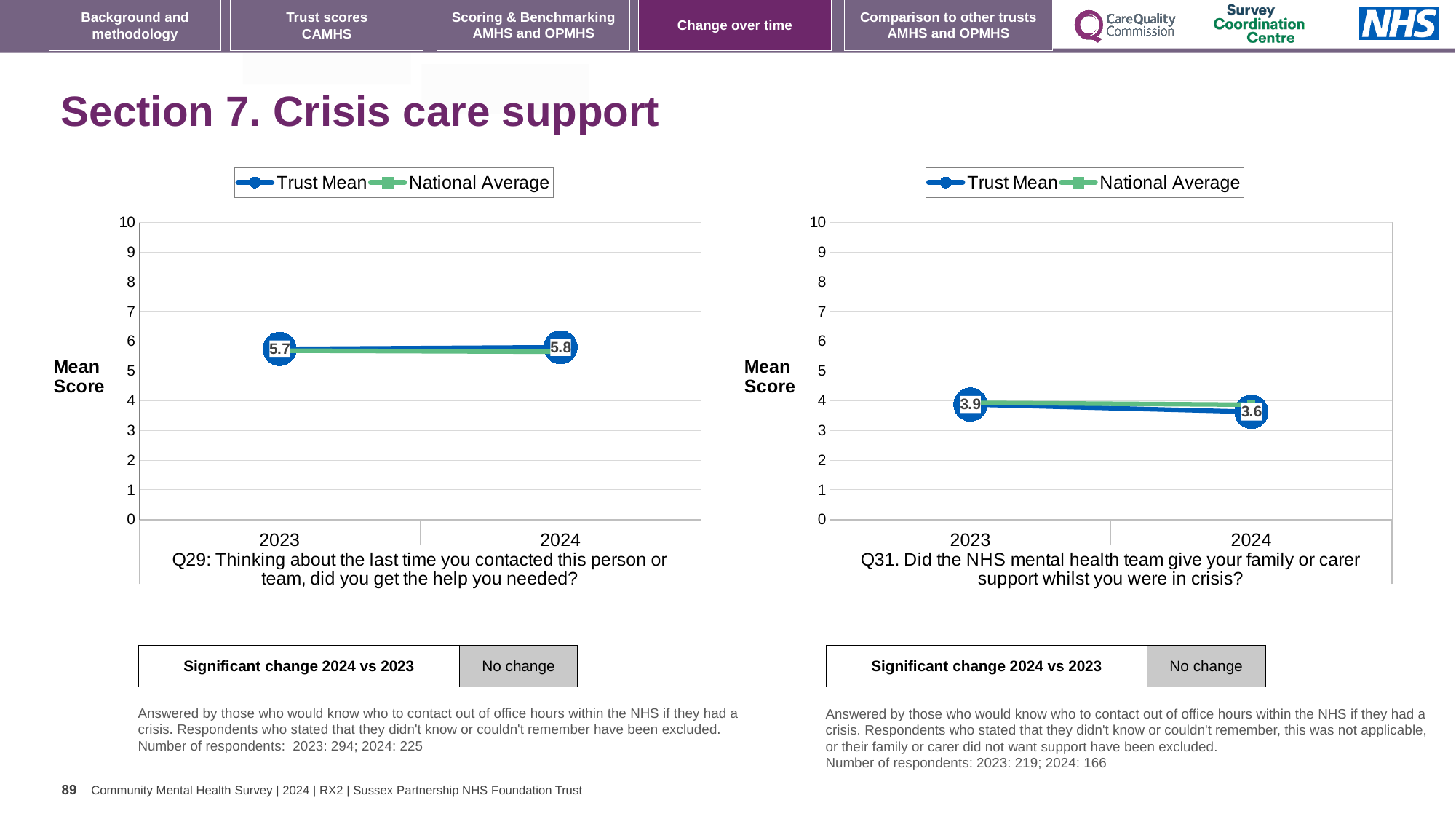
In the Q31 chart on the right, by how much did the Trust Mean change from 2023 to 2024? 0.3 What kind of chart is the Q29 chart on the left? line chart In the Q31 chart on the right, what is the Trust Mean for 2023? 3.9 What is the label of the y axis on the Q29 chart on the left? Mean Score In the Q31 chart on the right, is the Trust Mean for 2024 greater or less than 4? less In the Q31 chart on the right, what is the Trust Mean for 2024? 3.6 How many years are plotted on the x axis of the Q31 chart on the right? 2 In the Q31 chart on the right, does the Trust Mean rise or fall from 2023 to 2024? fall In the Q29 chart on the left, what is the difference between the Trust Mean for 2024 and 2023? 0.1 In the Q29 chart on the left, what is the Trust Mean for 2023? 5.7 How many series does the legend of the Q29 chart on the left list? 2 In the Q29 chart on the left, what is the Trust Mean for 2024? 5.8